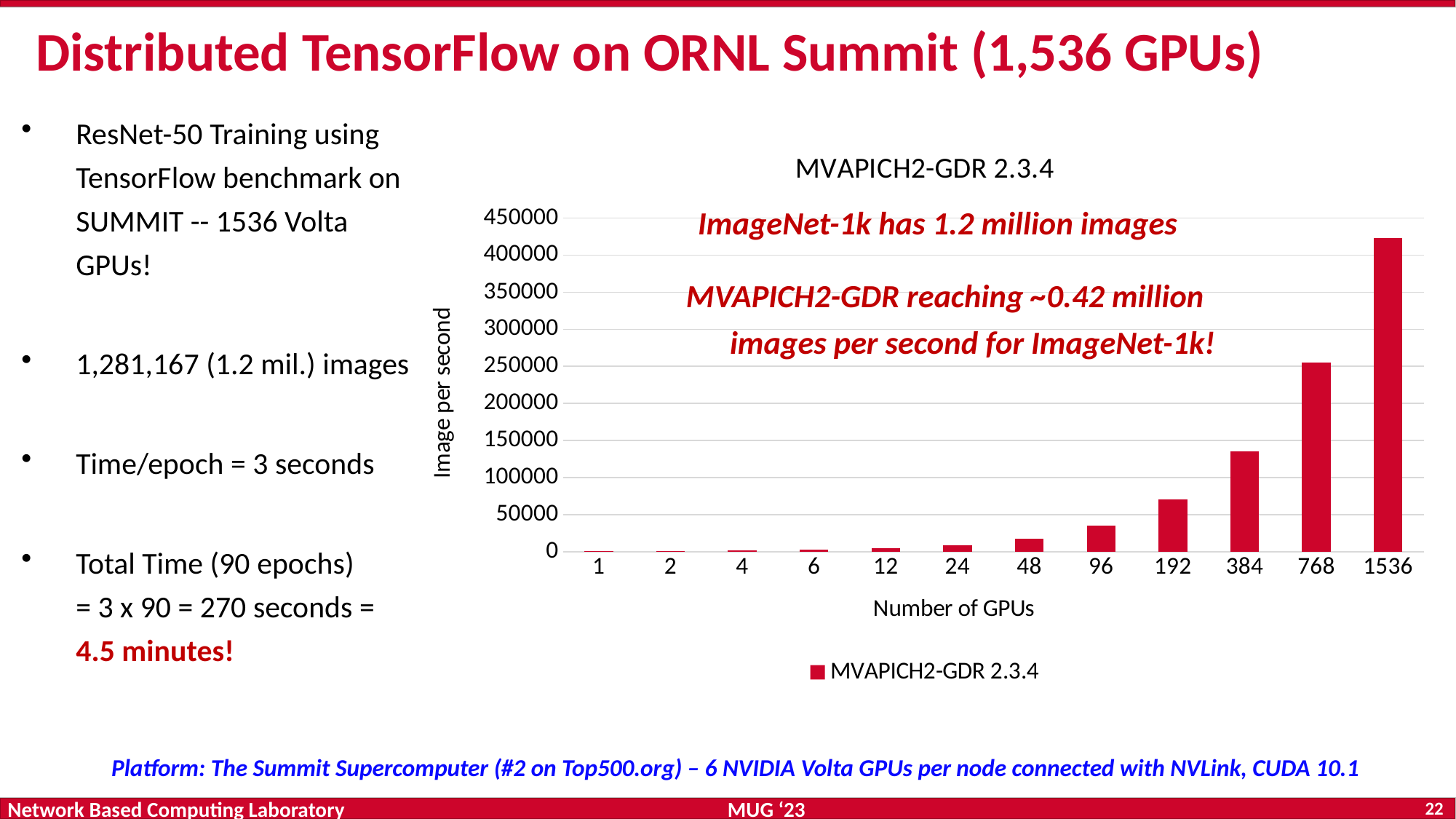
How many GPU counts (categories) are plotted along the x axis? 12 How many series does the chart legend list? 1 What is the label of the vertical axis of the chart? Image per second Which number of GPUs has the highest images per second? 1536 Which has a higher images per second value, 768 GPUs or 384 GPUs? 768 What is the title of the chart? MVAPICH2-GDR 2.3.4 Is the value for 384 GPUs greater or less than 150000? less What kind of chart is shown on the slide? bar chart Do the images per second rise or fall as the number of GPUs increases along the x axis? rise Which number of GPUs has the lowest images per second? 1 Is the value for 1536 GPUs greater or less than 400000? greater Is the value for 768 GPUs greater or less than 200000? greater